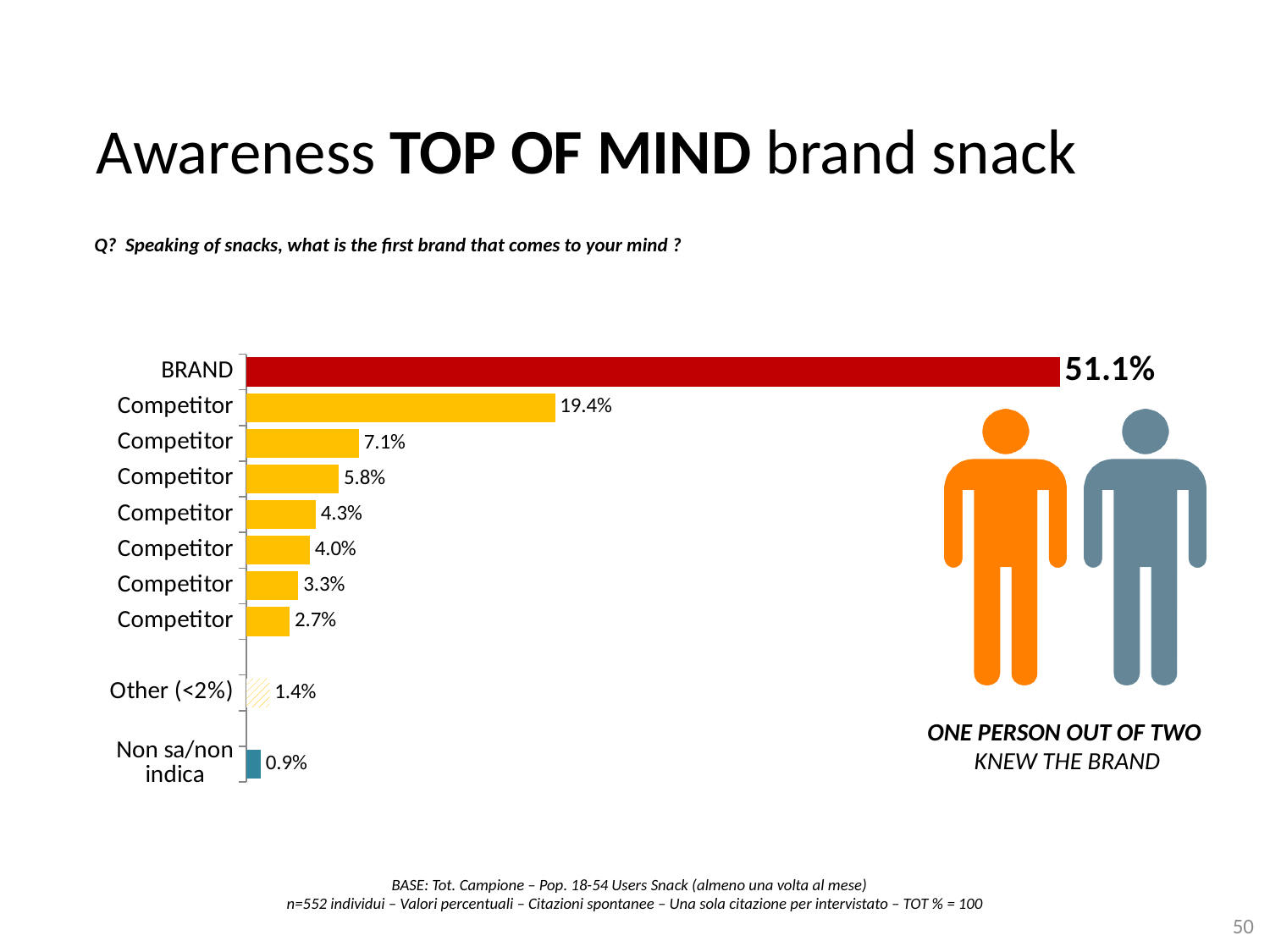
What is the value shown for Non sa/non indica? 0.9% Which is larger, Other (<2%) or Non sa/non indica? Other (<2%) Which category has the lowest value? Non sa/non indica What kind of chart is shown? Bar chart What is the difference between Other (<2%) and Non sa/non indica? 0.5 percentage points Which category has the highest value? BRAND What is the value shown for Other (<2%)? 1.4% What is the value of the largest Competitor bar? 19.4% How many bars are plotted in the chart? 10 What is the value shown for BRAND? 51.1% What is the difference between BRAND and the largest Competitor bar? 31.7 percentage points What is the value of the smallest Competitor bar? 2.7%